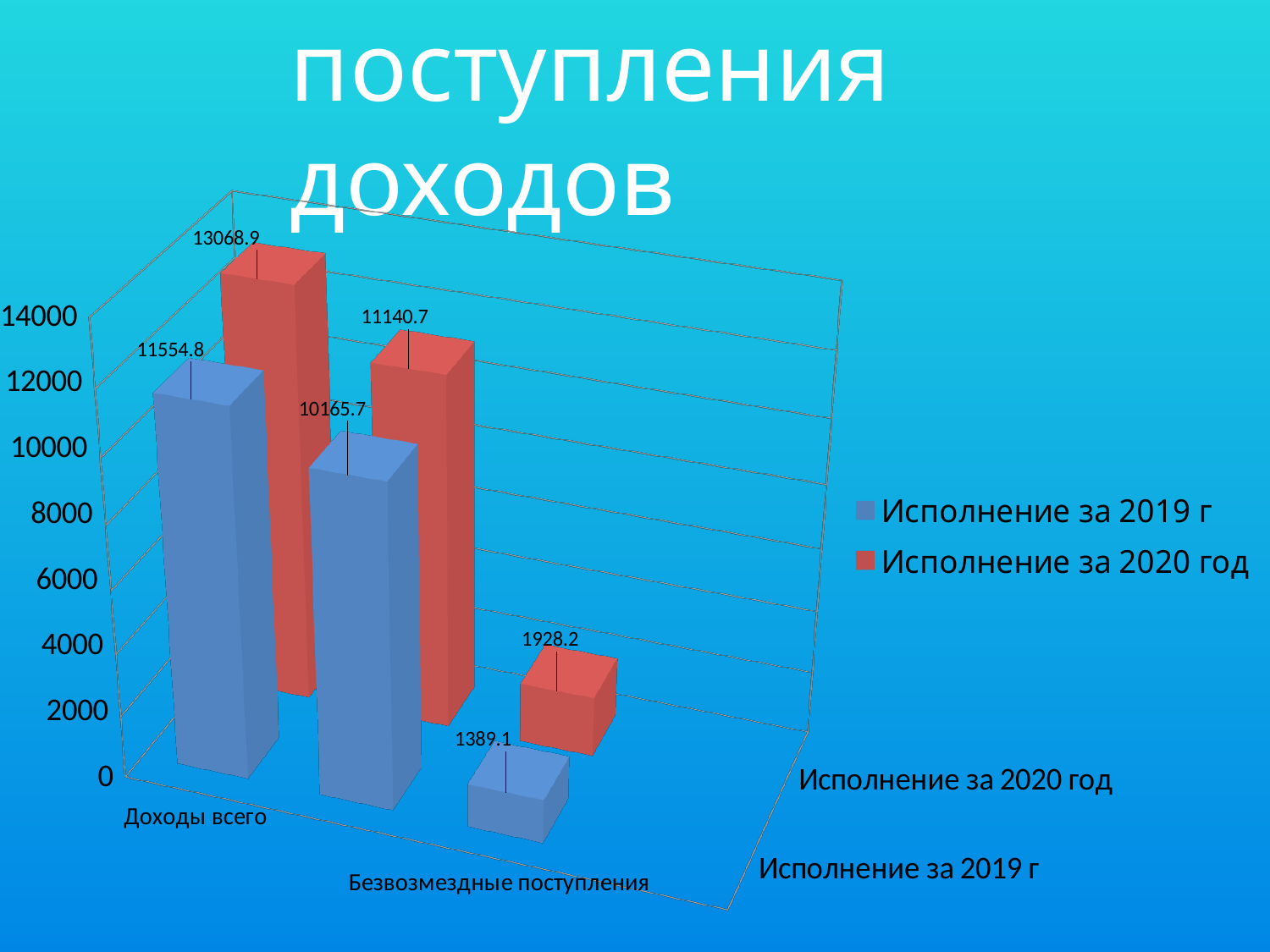
What is the value for Безвозмездные поступления in the Исполнение за 2019 г series? 1389.1 Which category has the lowest value in the Исполнение за 2019 г series? Безвозмездные поступления By how much does the Исполнение за 2020 год value for Доходы всего exceed the Исполнение за 2019 г value? 1514.1 What is the difference between the 2020 and 2019 values for Безвозмездные поступления? 539.1 What is the value for Доходы всего in the Исполнение за 2020 год series? 13068.9 Which category has the highest value in the Исполнение за 2020 год series? Доходы всего What is the value for Безвозмездные поступления in the Исполнение за 2020 год series? 1928.2 For Доходы всего, which series has the larger value: Исполнение за 2019 г or Исполнение за 2020 год? Исполнение за 2020 год What is the value for Доходы всего in the Исполнение за 2019 г series? 11554.8 How many series does the legend list? 2 How many categories are plotted on the chart? 3 What kind of chart is shown on the slide? Bar chart